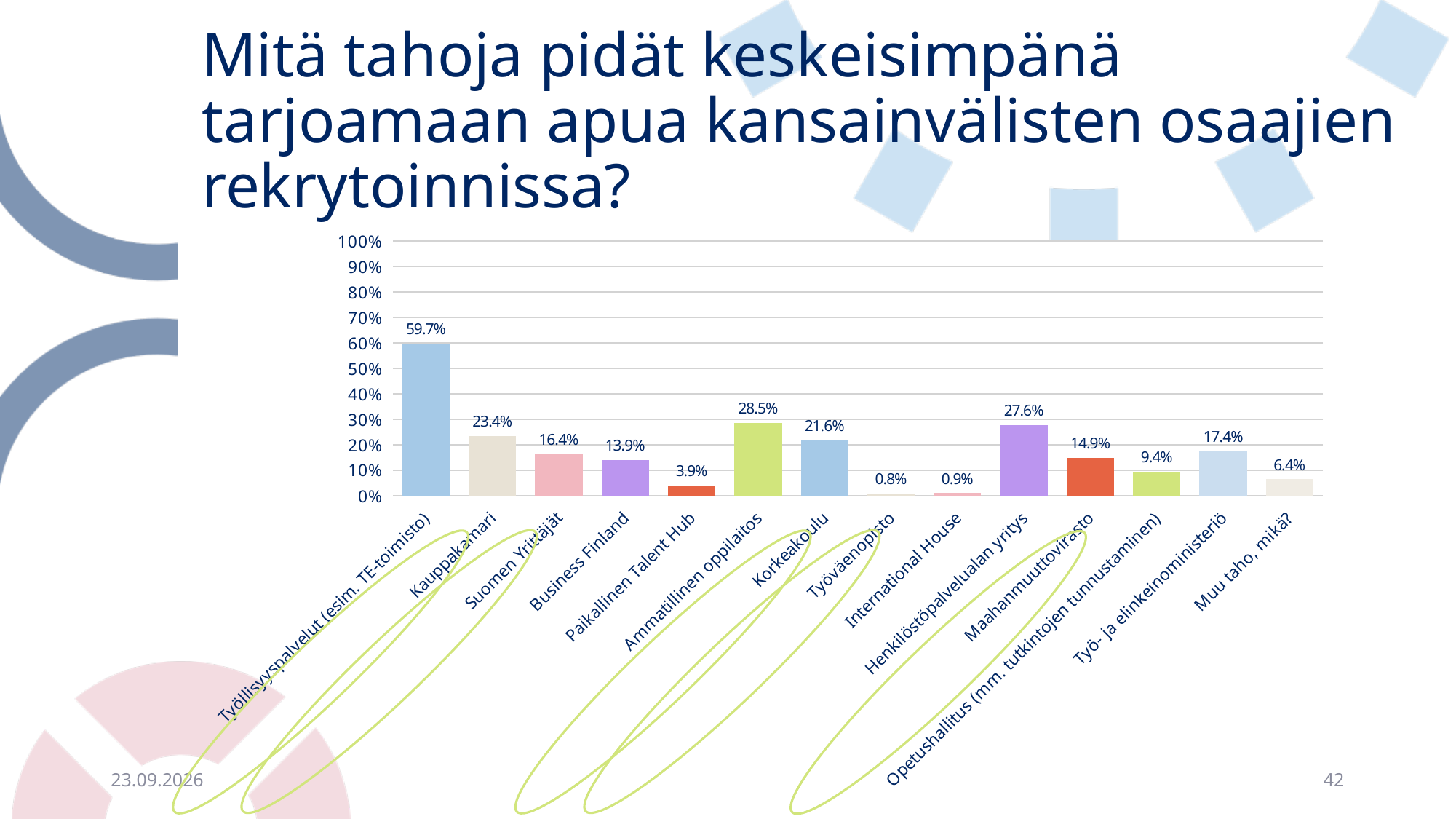
How many categories are shown in the chart? 14 Is the value for Maahanmuuttovirasto greater or less than 20%? less What is the value for Opetushallitus (mm. tutkintojen tunnustaminen)? 9.4% Which category has the lowest value? Työväenopisto Which category has the highest value? Työllisyyspalvelut (esim. TE-toimisto) What kind of chart is shown on the slide? bar chart What is the value for Henkilöstöpalvelualan yritys? 27.6% What is the difference between the values for Työ- ja elinkeinoministeriö and Muu taho, mikä? 11.0% What is the difference between the values for Kauppakamari and Suomen Yrittäjät? 7.0% Which is larger, the value for Korkeakoulu or the value for Business Finland? Korkeakoulu What is the value for Ammatillinen oppilaitos? 28.5% What is the value for Työllisyyspalvelut (esim. TE-toimisto)? 59.7%